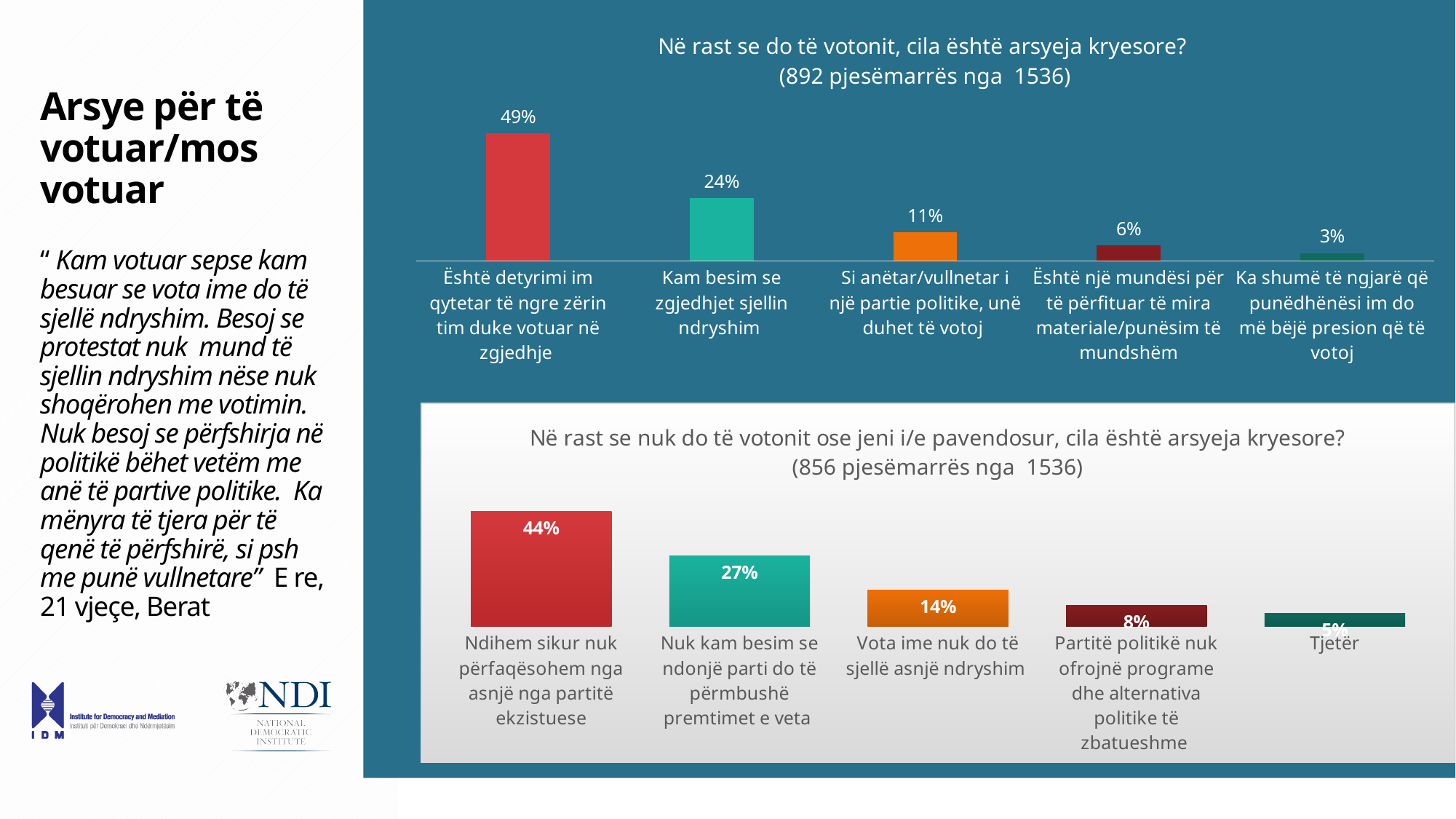
In the bottom chart (Në rast se nuk do të votonit ose jeni i/e pavendosur...), what is the difference between the values for "Ndihem sikur nuk përfaqësohem..." and "Nuk kam besim se ndonjë parti..."? 17% In the bottom chart (Në rast se nuk do të votonit ose jeni i/e pavendosur...), what is the value for "Tjetër"? 5% In the top chart (Në rast se do të votonit, cila është arsyeja kryesore?), what is the difference between the values for "Është detyrimi im qytetar..." and "Kam besim se zgjedhjet sjellin ndryshim"? 25% In the bottom chart (Në rast se nuk do të votonit ose jeni i/e pavendosur...), what is the value for "Vota ime nuk do të sjellë asnjë ndryshim"? 14% In the bottom chart (Në rast se nuk do të votonit ose jeni i/e pavendosur...), which is larger: "Nuk kam besim se ndonjë parti do të përmbushë premtimet e veta" or "Partitë politikë nuk ofrojnë programe dhe alternativa politike të zbatueshme"? Nuk kam besim se ndonjë parti do të përmbushë premtimet e veta What type of chart is the top chart (Në rast se do të votonit, cila është arsyeja kryesore?)? Bar chart In the top chart (Në rast se do të votonit, cila është arsyeja kryesore?), which category has the lowest value? Ka shumë të ngjarë që punëdhënësi im do më bëjë presion që të votoj In the top chart (Në rast se do të votonit, cila është arsyeja kryesore?), which category has the highest value? Është detyrimi im qytetar të ngre zërin tim duke votuar në zgjedhje In the top chart (Në rast se do të votonit, cila është arsyeja kryesore?), what is the value for "Kam besim se zgjedhjet sjellin ndryshim"? 24% In the top chart (Në rast se do të votonit, cila është arsyeja kryesore?), what is the value for "Si anëtar/vullnetar i një partie politike, unë duhet të votoj"? 11% In the top chart (Në rast se do të votonit, cila është arsyeja kryesore?), how many categories are shown? 5 In the bottom chart (Në rast se nuk do të votonit ose jeni i/e pavendosur...), which category has the highest value? Ndihem sikur nuk përfaqësohem nga asnjë nga partitë ekzistuese